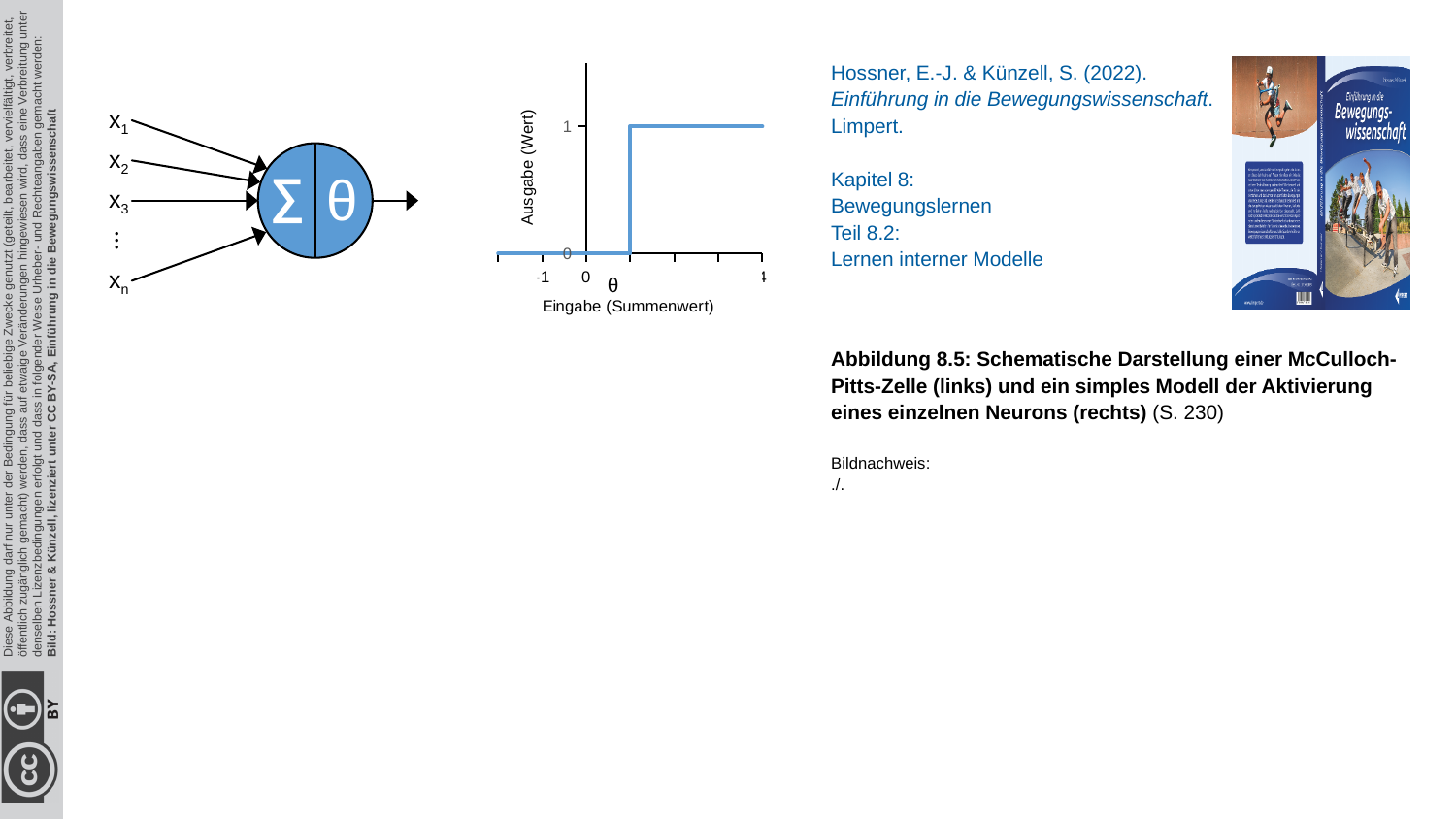
How many tick labels are printed on the x axis of the chart? 4 What is the lowest output value shown by the line? 0 Do the plotted values rise or fall as the input (Eingabe) increases along the x axis? rise What is the title of the x axis of the chart? Eingabe (Summenwert) What is the title of the y axis of the chart? Ausgabe (Wert) At which labelled point on the x axis does the line jump from 0 to 1? θ What kind of chart is shown on the slide? line chart What output value (Ausgabe) does the line show for inputs above θ? 1 What is the highest output value reached by the line? 1 What is the difference between the output value above θ and the output value below θ? 1 What output value (Ausgabe) does the line show for inputs below θ? 0